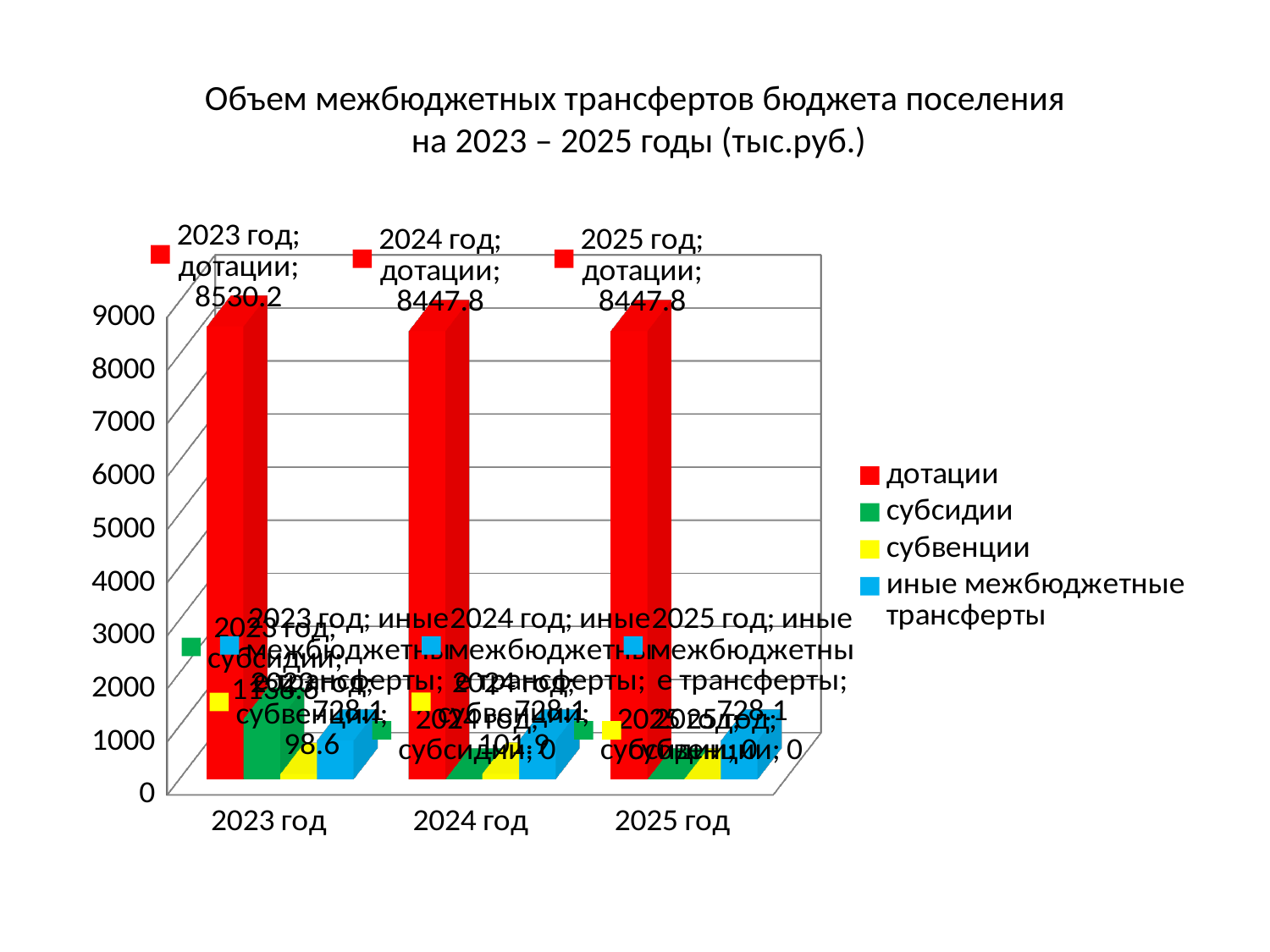
How many year categories are shown on the x axis? 3 What is the value of дотации for 2023 год? 8530.2 How many series does the legend list? 4 Is the value of дотации for 2023 год greater or less than 8000? greater Which series is shown in red in the legend? дотации What is the value of дотации for 2025 год? 8447.8 What is the value of иные межбюджетные трансферты for 2023 год? 728.1 In which year is the value of дотации highest? 2023 год Which is larger: дотации in 2023 год or дотации in 2025 год? 2023 год What is the value of дотации for 2024 год? 8447.8 What is the difference between the дотации values for 2023 год and 2024 год? 82.4 What kind of chart is shown on the slide? bar chart